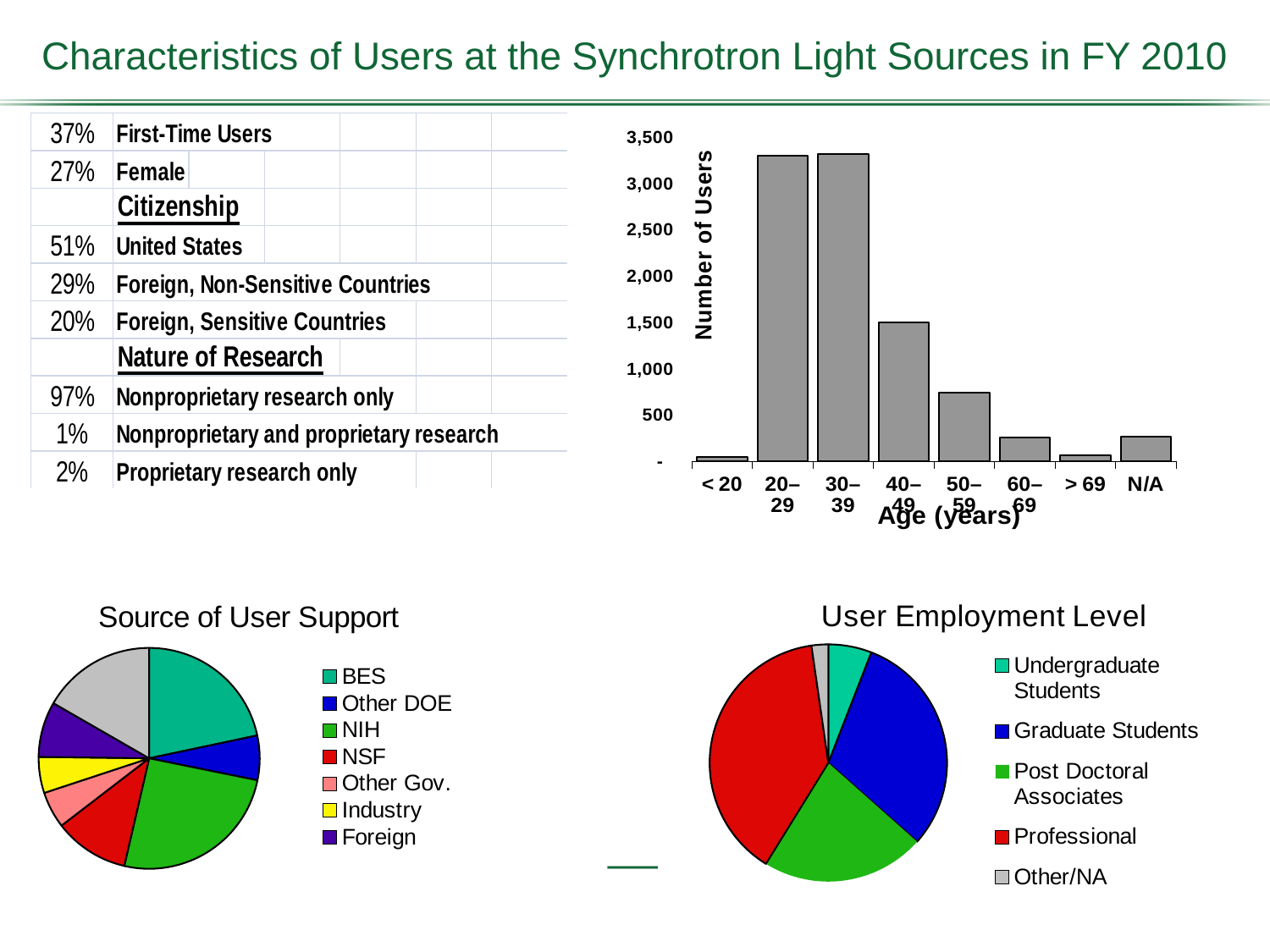
What is the label of the y axis on the bar chart of users by age? Number of Users What kind of chart is the Source of User Support chart? pie chart In the Number of Users bar chart, is the value for the 50–59 age group greater or less than 1,000? less In the Number of Users bar chart, is the value for the 40–49 age group greater or less than 1,000? greater How many age categories are shown on the x axis of the Number of Users bar chart? 8 What kind of chart is the chart of Number of Users by Age (years)? bar chart In the Number of Users bar chart, which is larger, the value for 40–49 or the value for 50–59? 40–49 In the User Employment Level pie chart, which category has the smallest slice? Other/NA In the User Employment Level pie chart, which category has the largest slice? Professional How many entries does the legend of the Source of User Support chart list? 7 In the Number of Users bar chart, do the values rise or fall from the 30–39 age group to the > 69 age group? fall In the Number of Users bar chart, is the value for the 20–29 age group greater or less than 3,000? greater